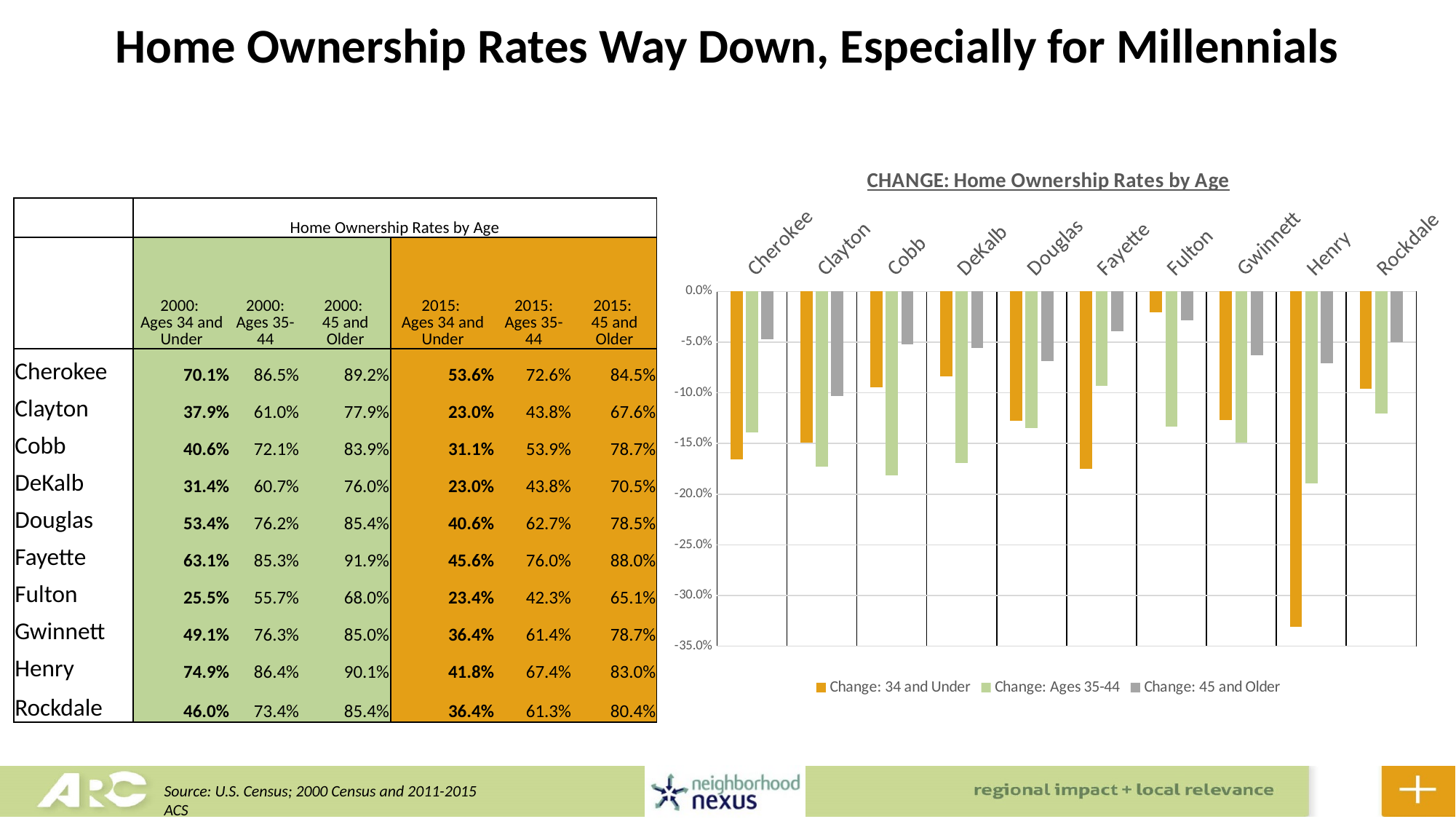
How many counties are shown on the x axis of the 'CHANGE: Home Ownership Rates by Age' chart? 10 In the 'CHANGE: Home Ownership Rates by Age' chart, is the 'Change: 45 and Older' value for Douglas greater or less than -5.0%? less In the 'CHANGE: Home Ownership Rates by Age' chart, which county shows a larger decline for 'Change: 34 and Under', Cherokee or Cobb? Cherokee In the 'CHANGE: Home Ownership Rates by Age' chart, is the 'Change: 34 and Under' value for Henry greater or less than -30.0%? less In the 'CHANGE: Home Ownership Rates by Age' chart, which county has the largest decline for 'Change: 45 and Older'? Clayton In the 'CHANGE: Home Ownership Rates by Age' chart, which county has the largest decline for 'Change: 34 and Under'? Henry How many series does the legend of the 'CHANGE: Home Ownership Rates by Age' chart list? 3 In the 'CHANGE: Home Ownership Rates by Age' chart, which county has the smallest decline (bar closest to zero) for 'Change: 34 and Under'? Fulton What colour represents the 'Change: 34 and Under' series in the 'CHANGE: Home Ownership Rates by Age' chart? orange In the 'CHANGE: Home Ownership Rates by Age' chart, is the 'Change: 34 and Under' value for Fulton greater or less than -5.0%? greater What type of chart is 'CHANGE: Home Ownership Rates by Age'? bar chart